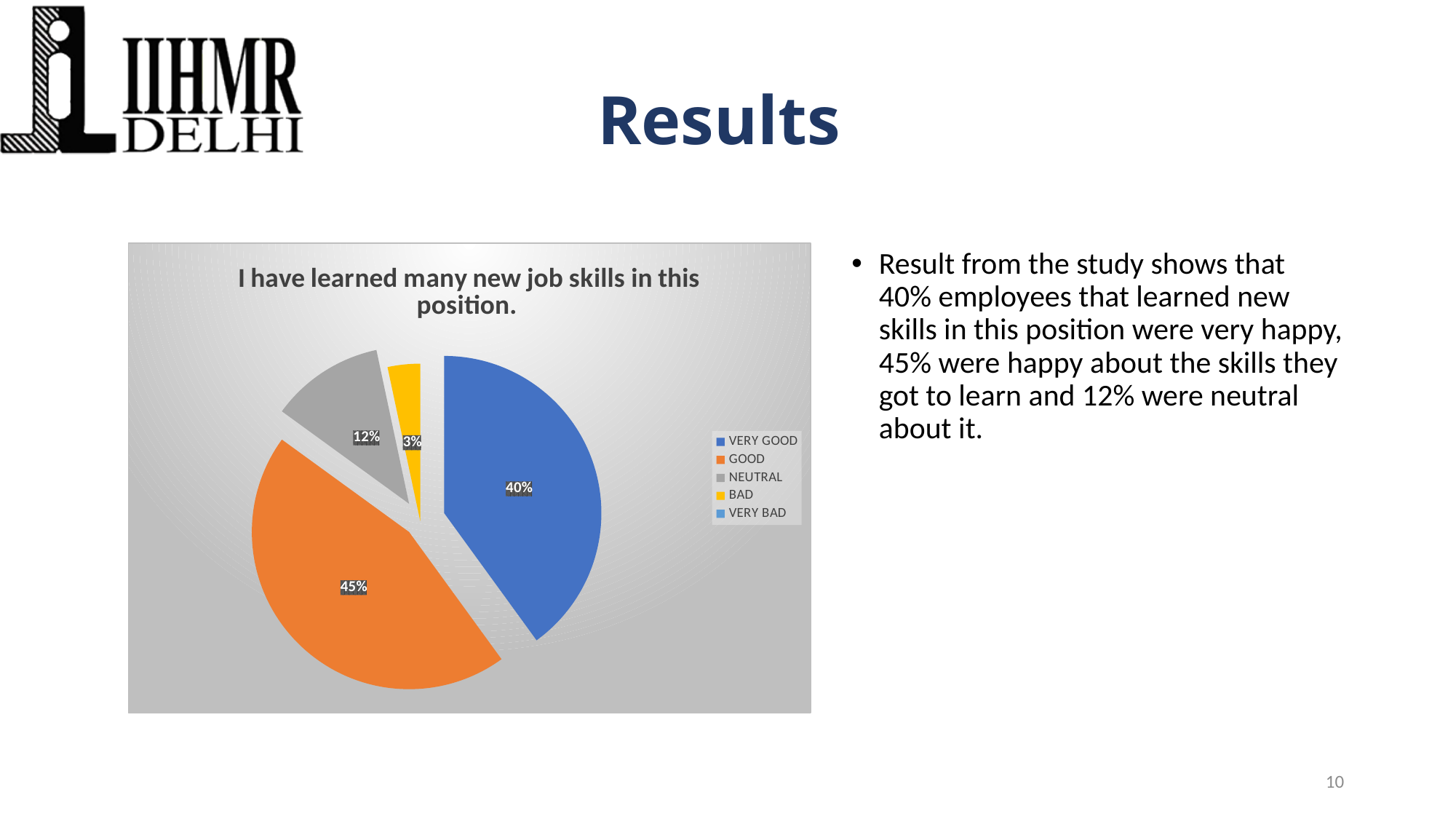
What percentage of the pie is the VERY GOOD slice? 40% Which category has the largest slice of the pie? GOOD Which labelled slice of the pie is the smallest? BAD What is the difference in percentage points between the GOOD and VERY GOOD slices? 5 What type of chart is shown on the slide? pie chart What percentage of the pie is the NEUTRAL slice? 12% What percentage of the pie is the BAD slice? 3% What colour is the GOOD slice? orange What is the title of the chart? I have learned many new job skills in this position. Which is larger, the NEUTRAL slice or the BAD slice? NEUTRAL What percentage of the pie is the GOOD slice? 45% How many categories does the legend list? 5